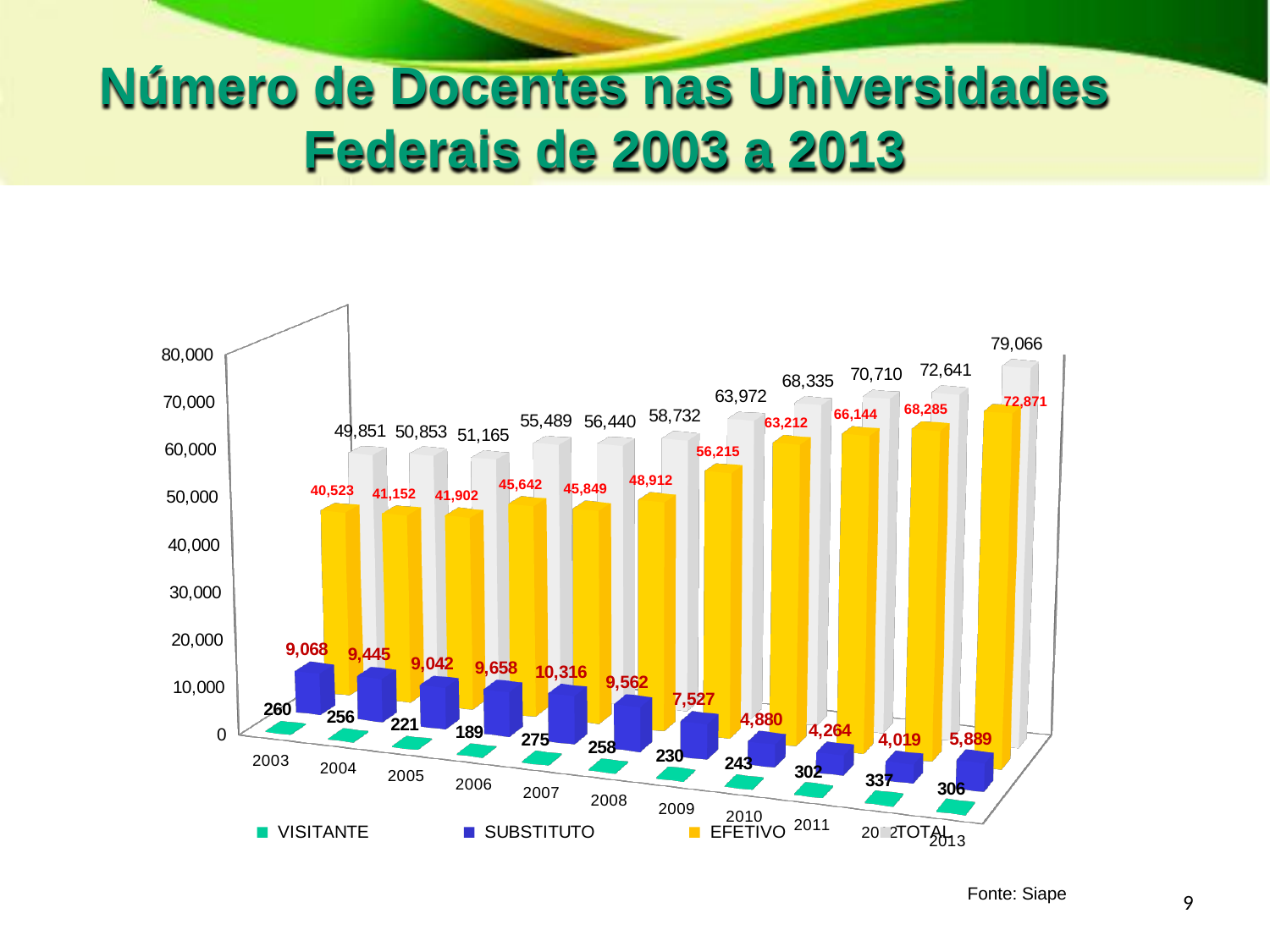
Which is larger, the EFETIVO value for 2010 or the TOTAL value for 2009? TOTAL value for 2009 Does the TOTAL series rise or fall from 2003 to 2013? rise In which year is the SUBSTITUTO value highest? 2007 In which year is the SUBSTITUTO value lowest? 2012 What is the difference between the TOTAL values for 2013 and 2003? 29,215 What is the SUBSTITUTO value for 2007? 10,316 What is the TOTAL number of docentes in 2013? 79,066 How many years are shown on the x axis? 11 How many series does the legend list? 4 In which year is the VISITANTE value highest? 2012 What is the EFETIVO value for 2009? 56,215 What is the VISITANTE value for 2006? 189